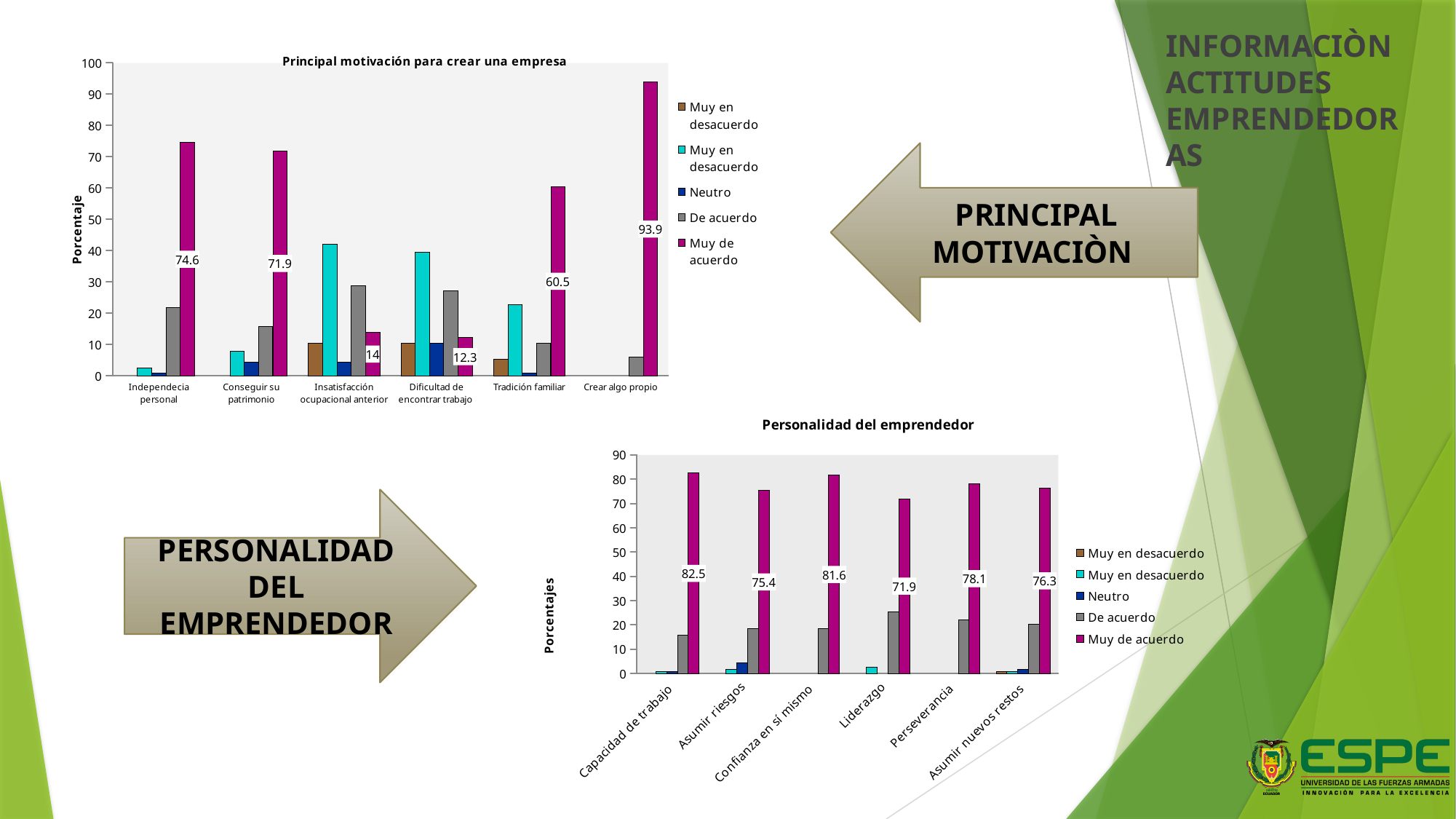
How many categories are shown on the x axis of the 'Principal motivación para crear una empresa' chart? 6 In the 'Personalidad del emprendedor' chart, which category has the highest 'Muy de acuerdo' value? Capacidad de trabajo In the 'Personalidad del emprendedor' chart, what is the 'Muy de acuerdo' value for Perseverancia? 78.1 In the 'Principal motivación para crear una empresa' chart, is the 'Muy en desacuerdo' (cyan) value for Insatisfacción ocupacional anterior greater or less than 40? greater In the 'Personalidad del emprendedor' chart, which is larger: the 'Muy de acuerdo' value for Asumir riesgos or for Asumir nuevos restos? Asumir nuevos restos In the 'Principal motivación para crear una empresa' chart, which category has the highest 'Muy de acuerdo' value? Crear algo propio In the 'Principal motivación para crear una empresa' chart, what is the 'Muy de acuerdo' value for Crear algo propio? 93.9 In the 'Principal motivación para crear una empresa' chart, what is the 'Muy de acuerdo' value for Tradición familiar? 60.5 In the 'Principal motivación para crear una empresa' chart, which category has the lowest 'Muy de acuerdo' value? Dificultad de encontrar trabajo How many series does the legend of the 'Personalidad del emprendedor' chart list? 5 In the 'Principal motivación para crear una empresa' chart, what is the difference between the 'Muy de acuerdo' values for Independencia personal and Conseguir su patrimonio? 2.7 In the 'Personalidad del emprendedor' chart, which category has the lowest 'Muy de acuerdo' value? Liderazgo